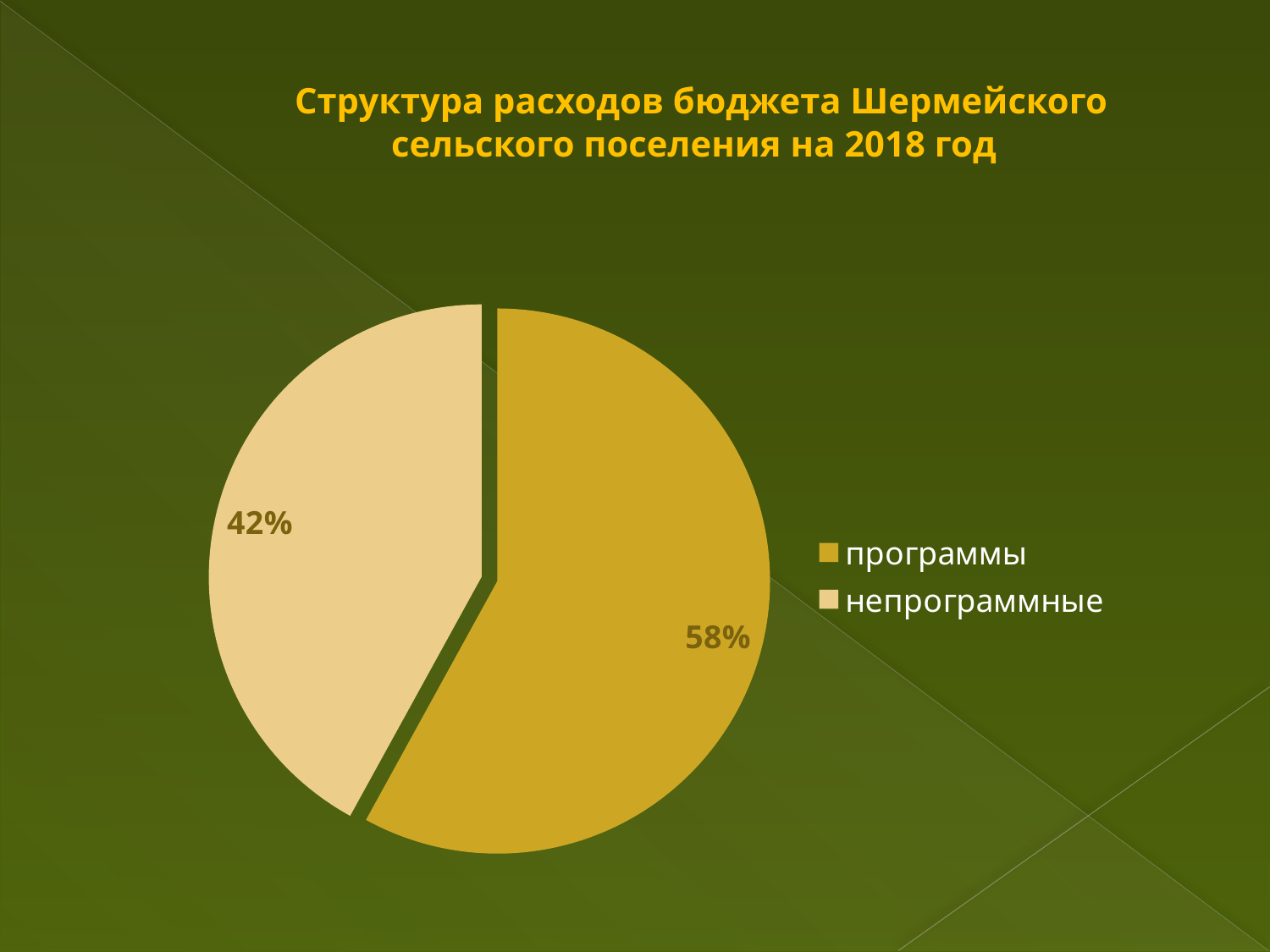
Is the share for 'непрограммные' greater or less than 50%? less What kind of chart is shown on the slide? Pie chart Which category has the largest slice of the pie? программы What is the title of the chart? Структура расходов бюджета Шермейского сельского поселения на 2018 год What share of the pie does the 'программы' slice represent? 58% Which category has the smallest slice of the pie? непрограммные How many slices does the pie chart have? 2 Which is larger: the 'программы' slice or the 'непрограммные' slice? программы What share of the pie does the 'непрограммные' slice represent? 42% Which legend entry is shown in the lighter beige colour? непрограммные What is the difference in percentage points between the 'программы' and 'непрограммные' slices? 16 percentage points How many entries does the legend list? 2